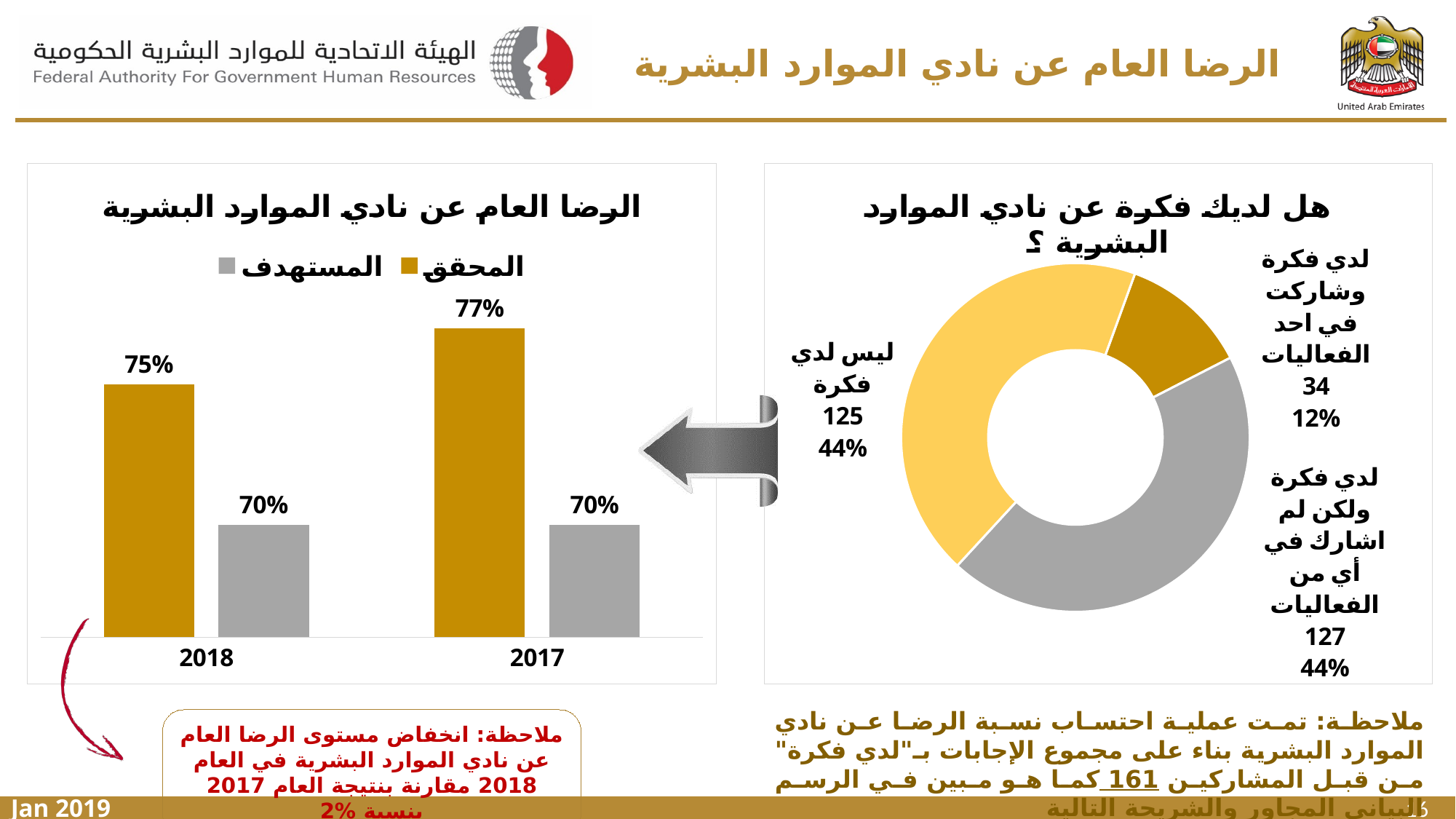
In the bar chart on the left, what is the value of المحقق for 2018? 75% In the bar chart on the left, what is the difference between المحقق and المستهدف for 2017? 7% In the doughnut chart on the right, which response has the smallest count? لدي فكرة وشاركت في احد الفعاليات In the doughnut chart on the right, how many response categories are shown? 3 In the bar chart on the left, what is the value of المحقق for 2017? 77% In the doughnut chart on the right, how many respondents answered ليس لدي فكرة? 125 In the doughnut chart on the right, what share of respondents answered لدي فكرة وشاركت في احد الفعاليات? 12% In the bar chart on the left, how many series does the legend list? 2 What type of chart is the chart on the left? Bar chart In the bar chart on the left, what is the value of المستهدف for 2018? 70% In the bar chart on the left, which year has the higher المحقق value, 2018 or 2017? 2017 In the doughnut chart on the right, what is the difference in count between لدي فكرة ولكن لم اشارك في أي من الفعاليات and ليس لدي فكرة? 2